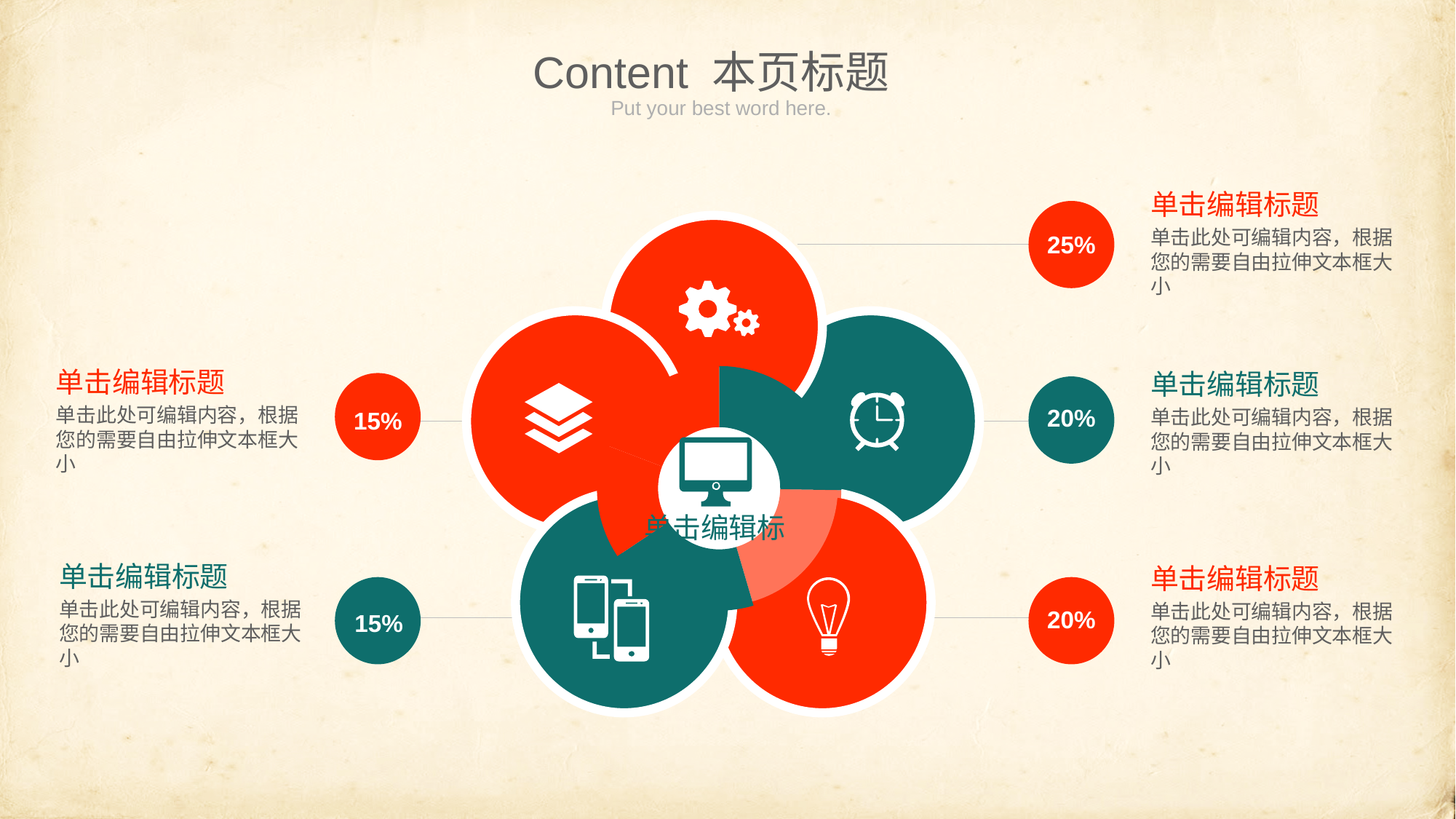
What percentage is shown in the small circle at the bottom left, next to the phones icon petal? 15% What is the difference between the top-right percentage (25%) and the middle-left percentage (15%)? 10% What is the title of the slide? Content 本页标题 What percentage is shown in the small circle on the middle left, next to the layers icon petal? 15% Which percentage value in the diagram is the highest? 25% How many percentage circles are shown around the diagram? 5 What is the sum of all five percentages shown in the diagram? 95% What percentage is shown in the small circle at the bottom right, next to the light bulb icon petal? 20% What percentage is shown in the small circle on the middle right, next to the clock icon petal? 20% What percentage is shown in the small circle at the top right of the diagram, next to the gear icon petal? 25% What colour is the small circle showing 25%? Red Which is larger, the percentage next to the gear petal or the percentage next to the clock petal? The gear petal (25%)